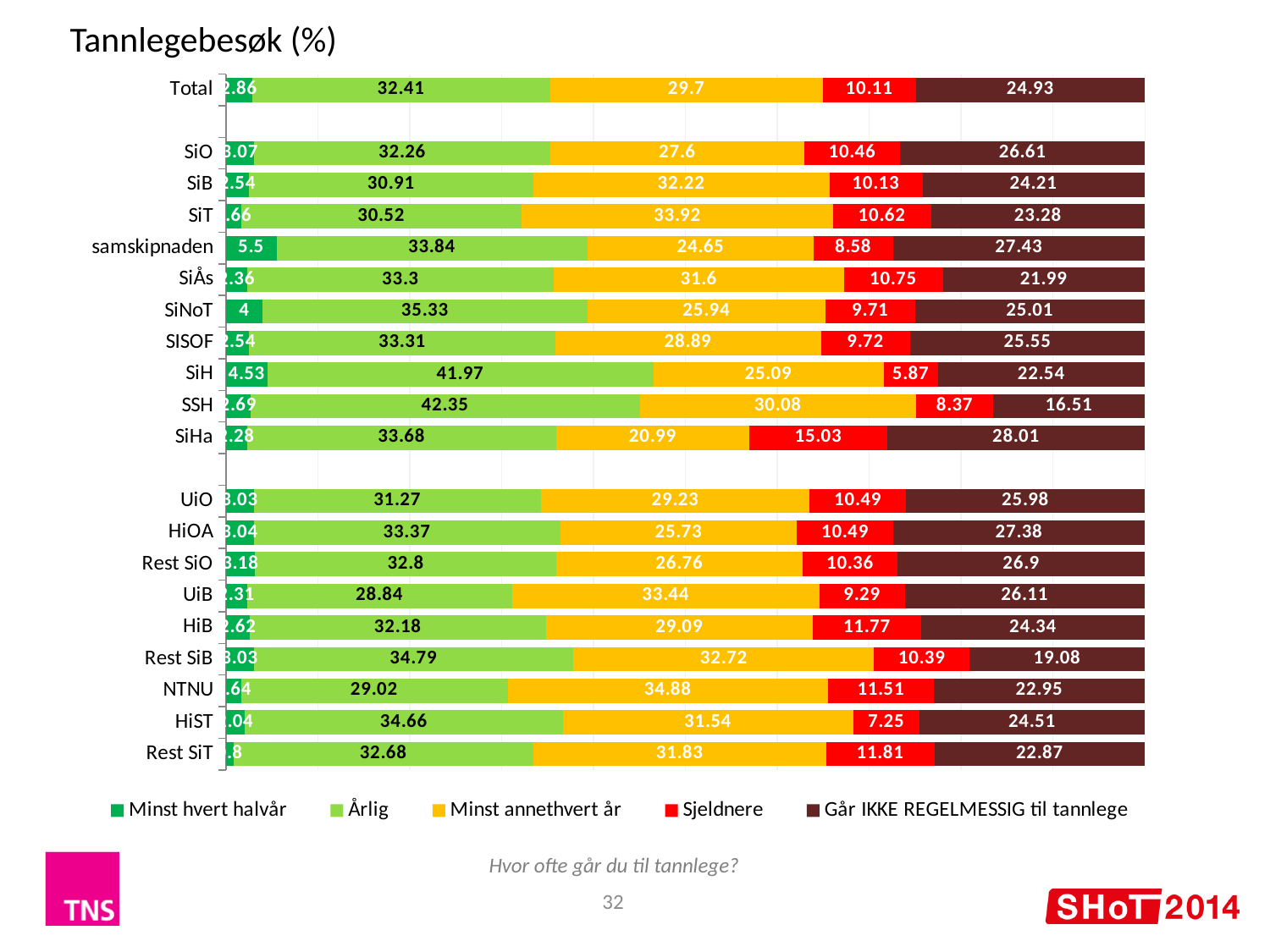
What is the value of 'Går IKKE REGELMESSIG til tannlege' for SiHa? 28.01 Which category has the highest value for 'Sjeldnere'? SiHa What is the value of 'Minst annethvert år' for SiHa? 20.99 What is the difference between the 'Sjeldnere' value for SiHa and for Total? 4.92 What kind of chart is shown on the slide? bar chart What is the value of 'Minst hvert halvår' for samskipnaden? 5.5 How many categories are plotted on the chart? 20 How many series does the legend list? 5 Which has the larger 'Minst annethvert år' value, NTNU or SiT? NTNU Which category has the lowest value for 'Sjeldnere'? SiH Which category has the highest value for 'Årlig'? SSH What is the value of 'Årlig' for SSH? 42.35